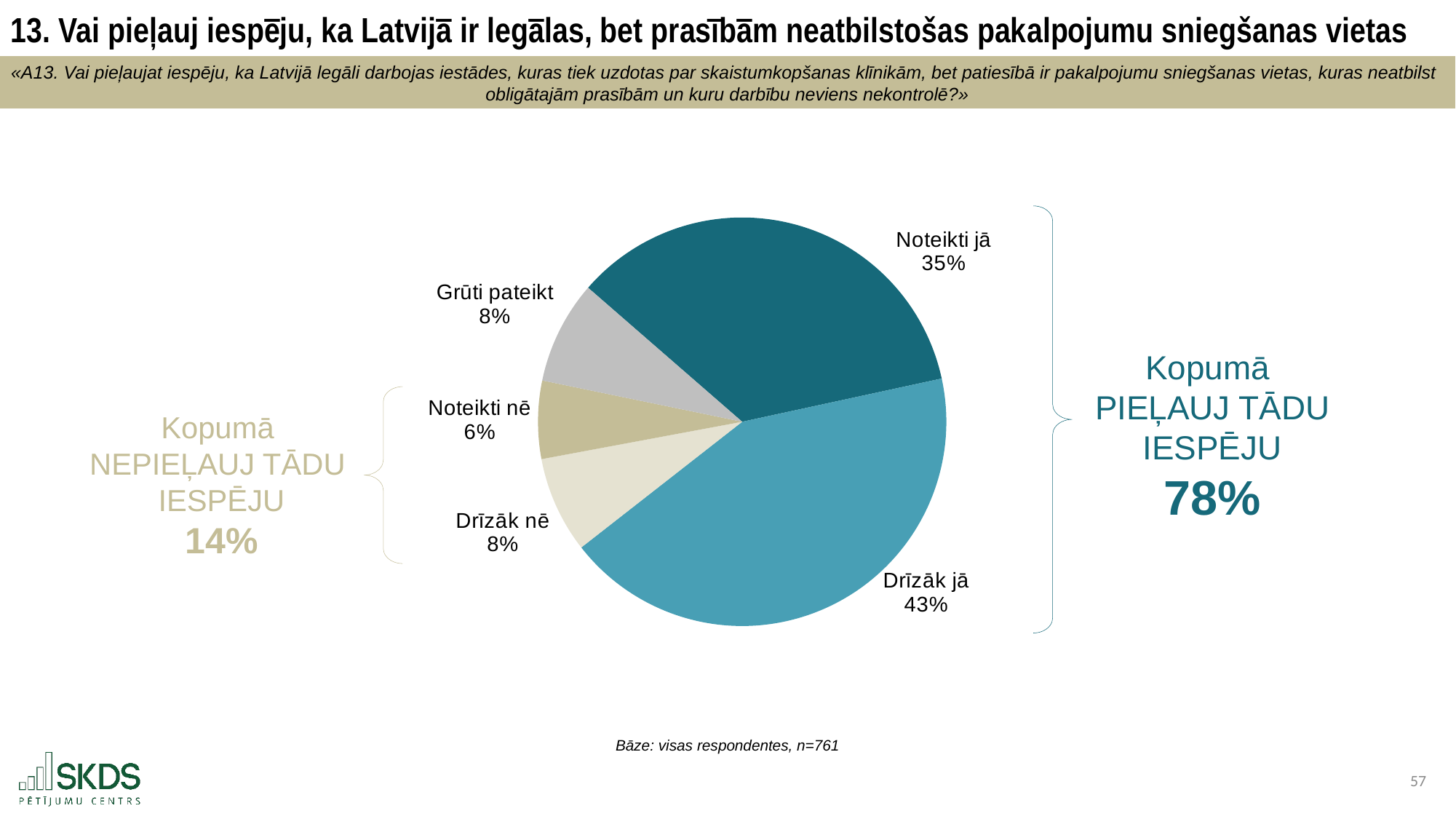
Which response has the smallest share of the pie? Noteikti nē What is the difference in percentage points between "Drīzāk jā" and "Noteikti jā"? 8 What percentage of respondents answered "Noteikti nē"? 6% What combined percentage is shown for "Kopumā PIEĻAUJ TĀDU IESPĒJU"? 78% What percentage of respondents answered "Grūti pateikt"? 8% What percentage of respondents answered "Drīzāk jā"? 43% What type of chart is shown on the slide? Pie chart What combined percentage is shown for "Kopumā NEPIEĻAUJ TĀDU IESPĒJU"? 14% How many slices does the pie chart have? 5 Which is larger, the share for "Noteikti jā" or the share for "Drīzāk nē"? Noteikti jā Which response has the largest share of the pie? Drīzāk jā What percentage of respondents answered "Noteikti jā"? 35%